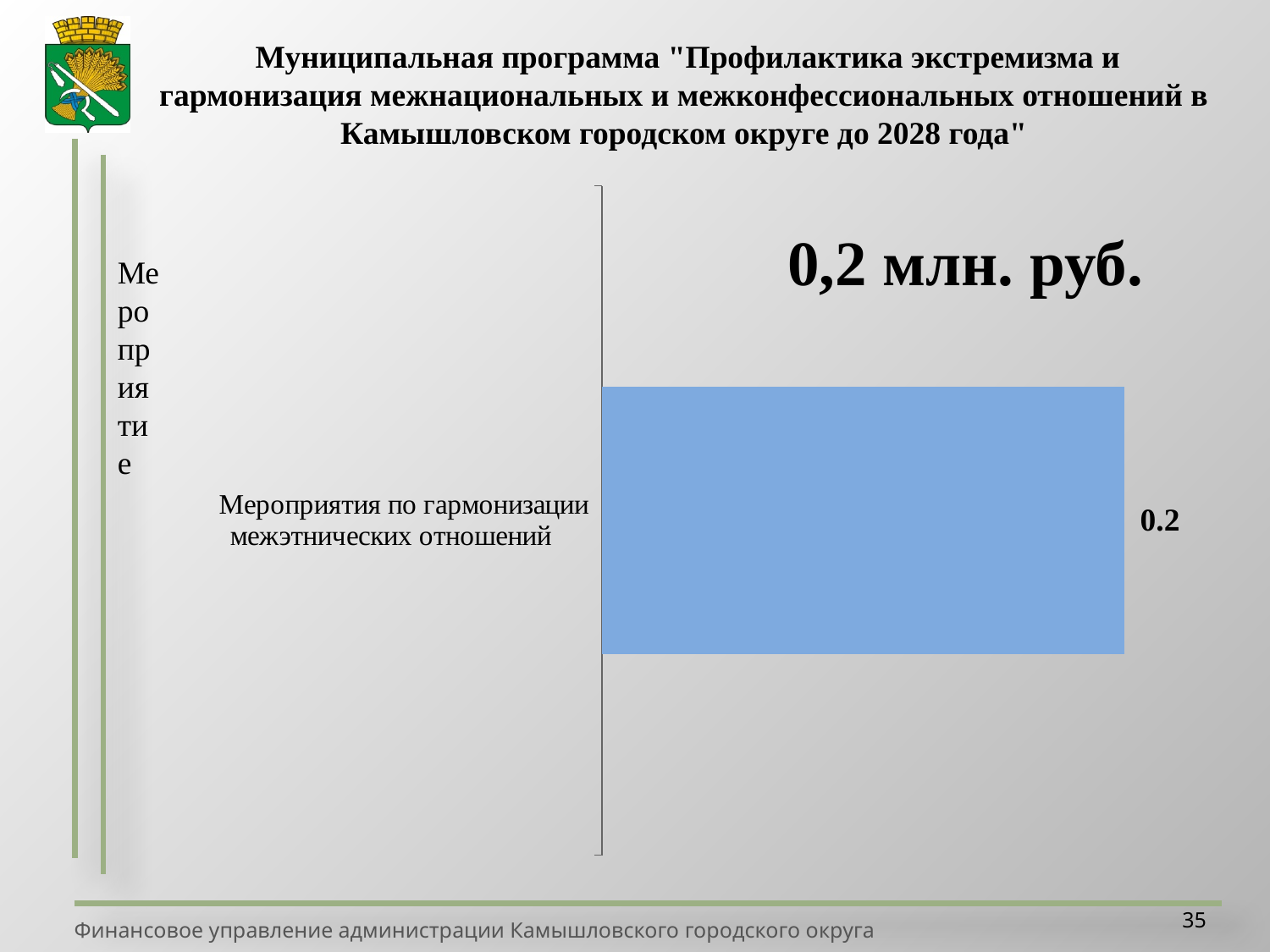
What is the name of the only category plotted in the chart? Мероприятия по гармонизации межэтнических отношений What amount in millions of roubles is printed in large text above the bar? 0,2 млн. руб. What colour is the bar in the chart? blue What value is shown for the bar labelled "Мероприятия по гармонизации межэтнических отношений"? 0.2 What kind of chart is shown on the slide? bar chart How many bars does the chart contain? 1